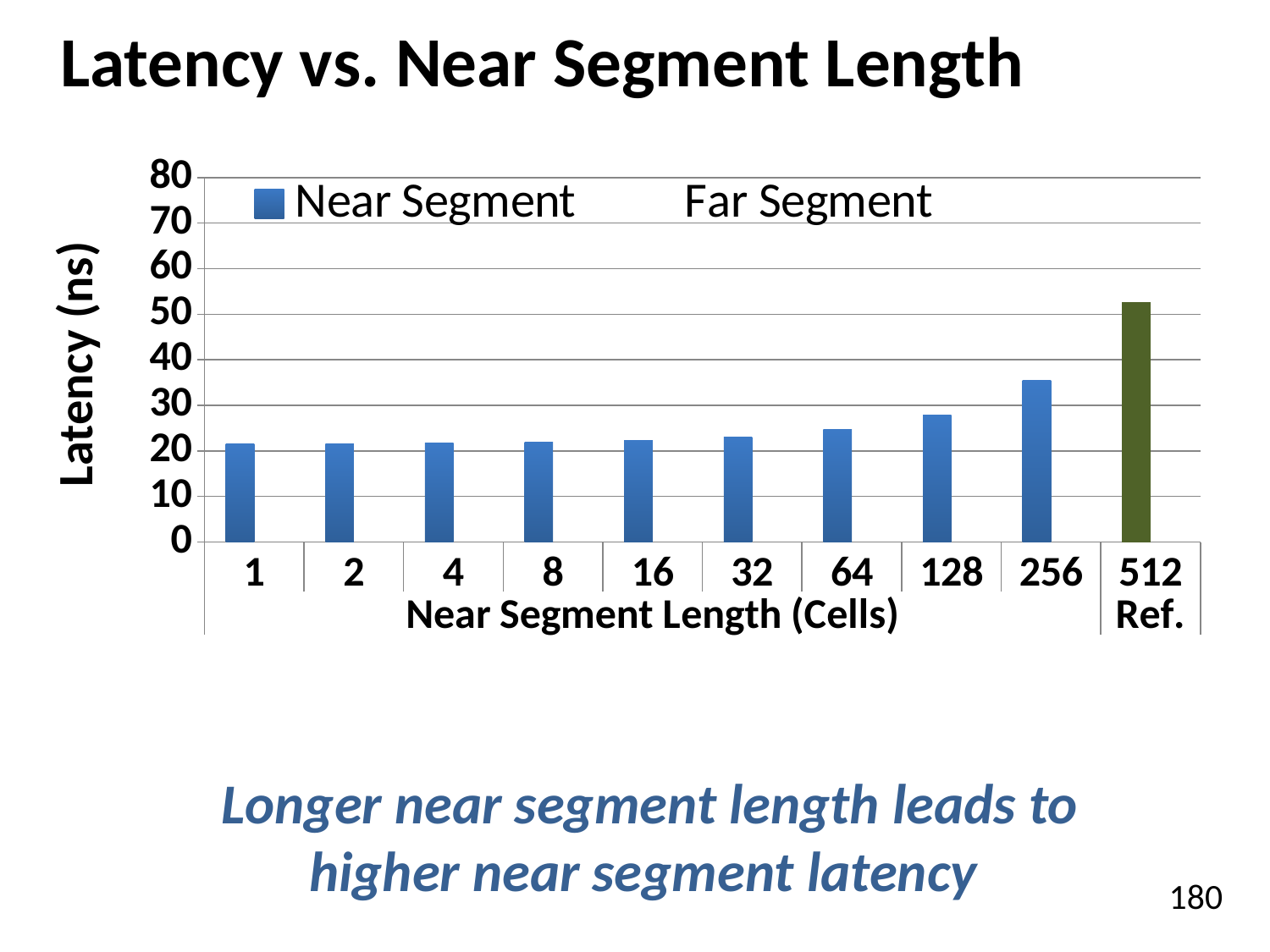
Do the near segment latency values rise or fall as near segment length increases along the x axis? rise How many categories are shown on the x axis of the chart? 10 Is the latency for a near segment length of 256 greater or less than 40? less What is the label of the y axis? Latency (ns) What kind of chart is shown on the slide? bar chart Is the latency for a near segment length of 1 greater or less than 20? greater How many series does the legend list? 2 Which has the higher latency, near segment length 256 or 128? 256 Is the latency for a near segment length of 128 greater or less than 30? less What is the title of the chart? Latency vs. Near Segment Length Which category has the highest latency? 512 Ref.